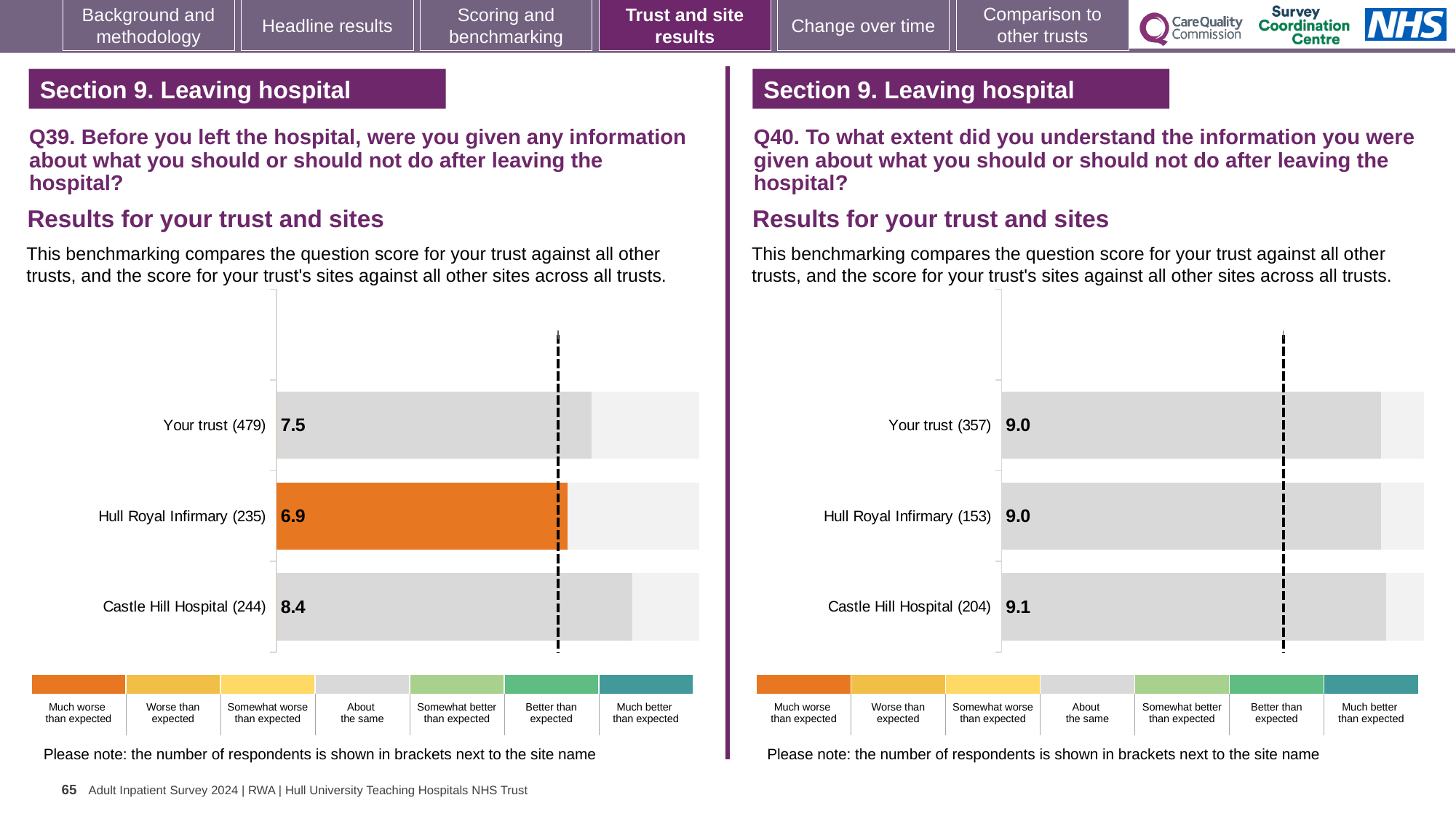
What kind of chart is used for the Q40 results on the right? Bar chart In the Q40 chart on the right, how many respondents are shown for Hull Royal Infirmary? 153 In the Q39 chart on the left, which site or trust has the highest score? Castle Hill Hospital In the Q40 chart on the right, what is the score for Castle Hill Hospital? 9.1 In the Q40 chart on the right, what is the score for Your trust? 9.0 In the Q39 chart on the left, what is the score for Hull Royal Infirmary? 6.9 In the Q39 chart on the left, which site or trust has the lowest score? Hull Royal Infirmary How many bars are plotted in the Q39 chart on the left? 3 In the Q39 chart on the left, what is the score for Castle Hill Hospital? 8.4 In the Q39 chart on the left, what is the difference between the scores for Castle Hill Hospital and Hull Royal Infirmary? 1.5 In the Q39 chart on the left, what is the score for Your trust? 7.5 In the Q39 chart on the left, which bar is coloured orange, indicating 'Much worse than expected'? Hull Royal Infirmary